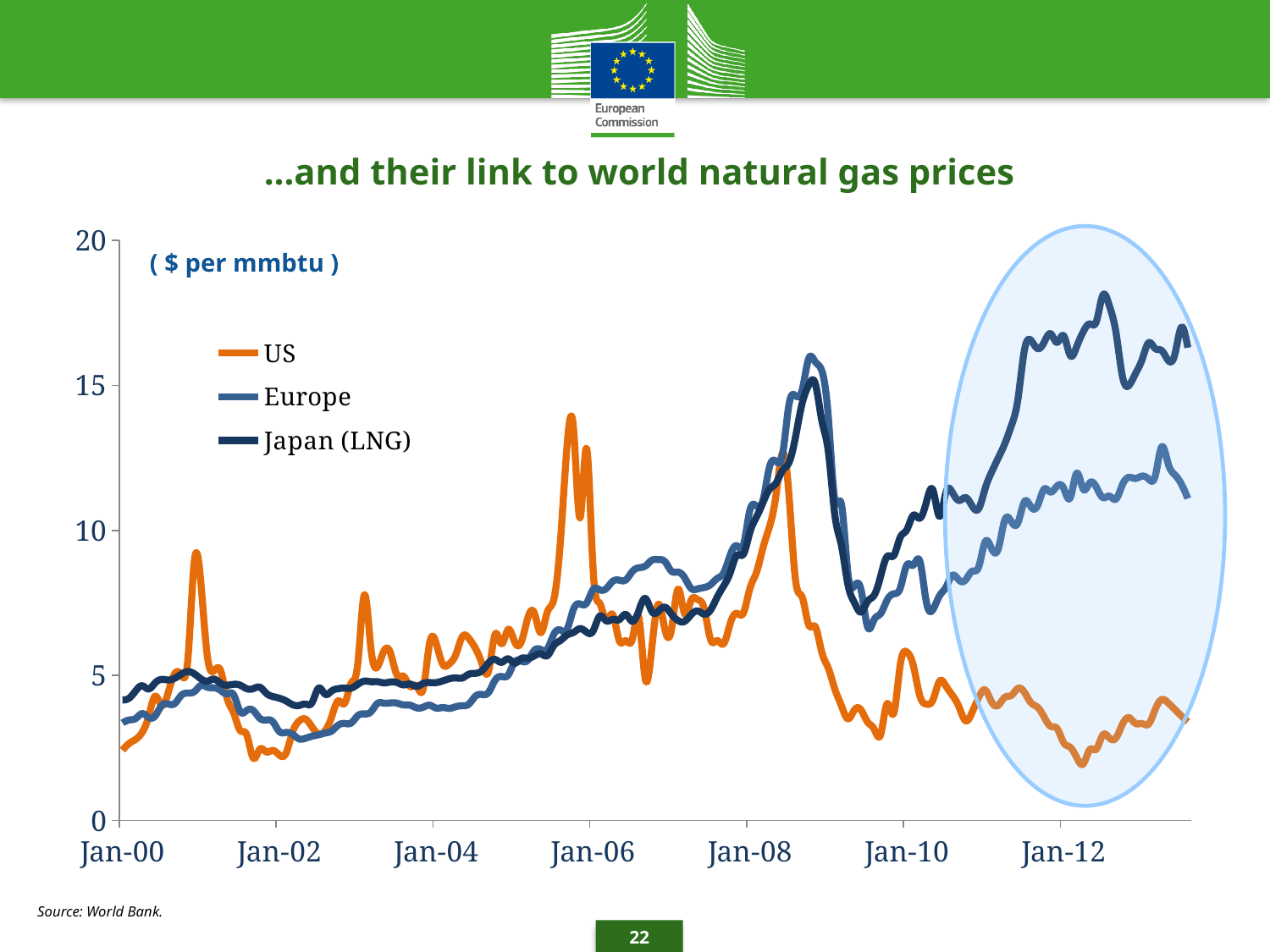
Which series are listed in the legend? US, Europe, Japan (LNG) Is the value for Japan (LNG) at Jan-12 greater or less than 15? greater At Jan-12, which is larger, the value for Europe or the value for US? Europe Which series has the lowest value at the right-hand end of the chart? US What kind of chart is shown on the slide? line chart How many labelled tick marks are on the x axis? 7 Is the value for Europe at Jan-12 greater or less than 10? greater Which series has the highest value at the right-hand end of the chart? Japan (LNG) Is the value for US at Jan-12 greater or less than 5? less Does the Japan (LNG) series rise or fall between Jan-10 and Jan-12? rise How many series does the legend list? 3 What unit is shown for the values on the chart? $ per mmbtu